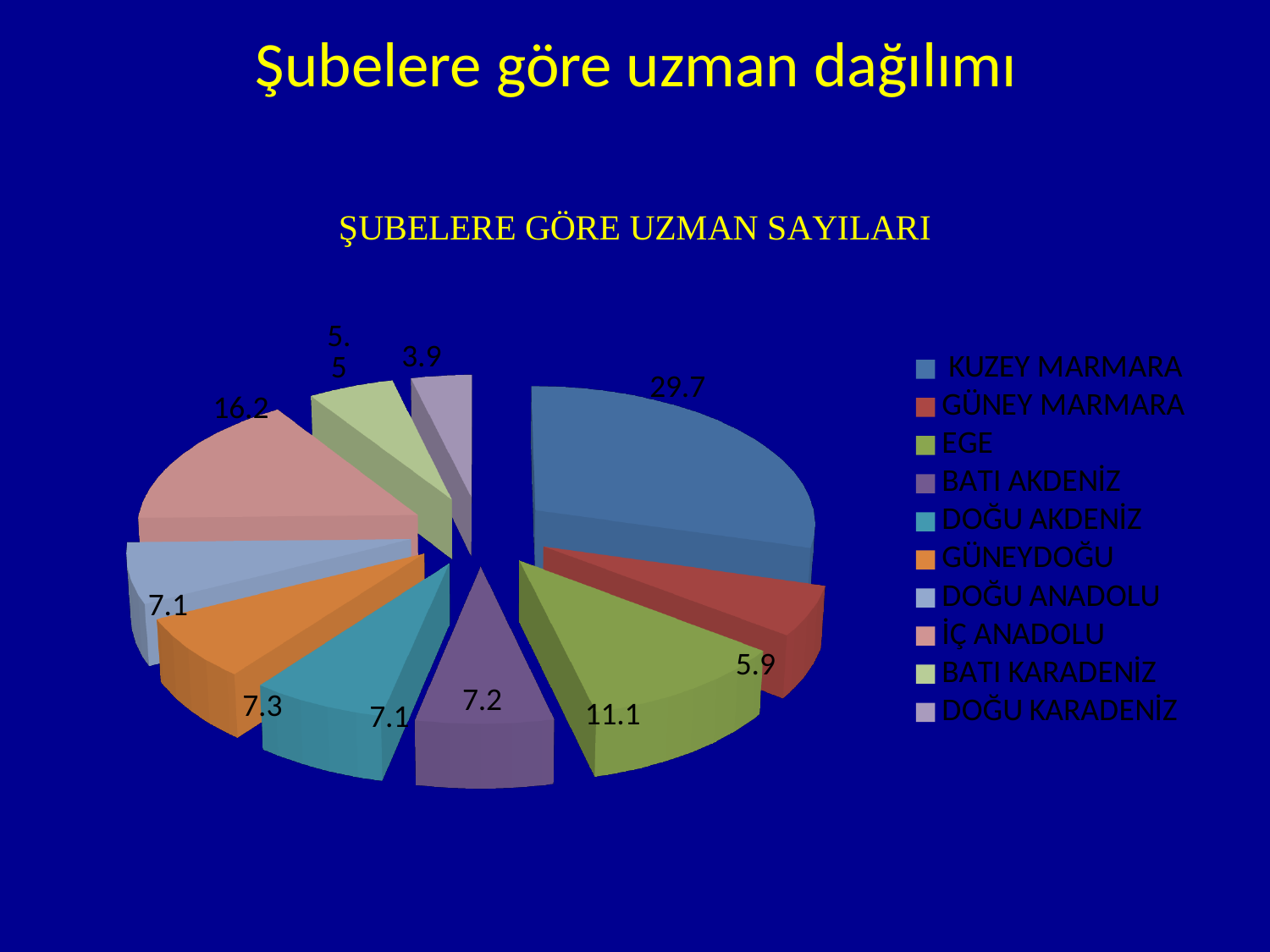
Which branch has the largest slice of the pie? KUZEY MARMARA What is the value shown for İÇ ANADOLU? 16.2 What is the title of the chart? ŞUBELERE GÖRE UZMAN SAYILARI What kind of chart is shown on the slide? pie chart What is the value shown for KUZEY MARMARA? 29.7 Which is larger, the value for EGE or the value for GÜNEY MARMARA? EGE How many branches (slices) does the pie chart show? 10 What is the value shown for DOĞU KARADENİZ? 3.9 What is the difference between the values for KUZEY MARMARA and İÇ ANADOLU? 13.5 Which branch has the smallest slice of the pie? DOĞU KARADENİZ What is the value shown for GÜNEYDOĞU? 7.3 What is the value shown for EGE? 11.1